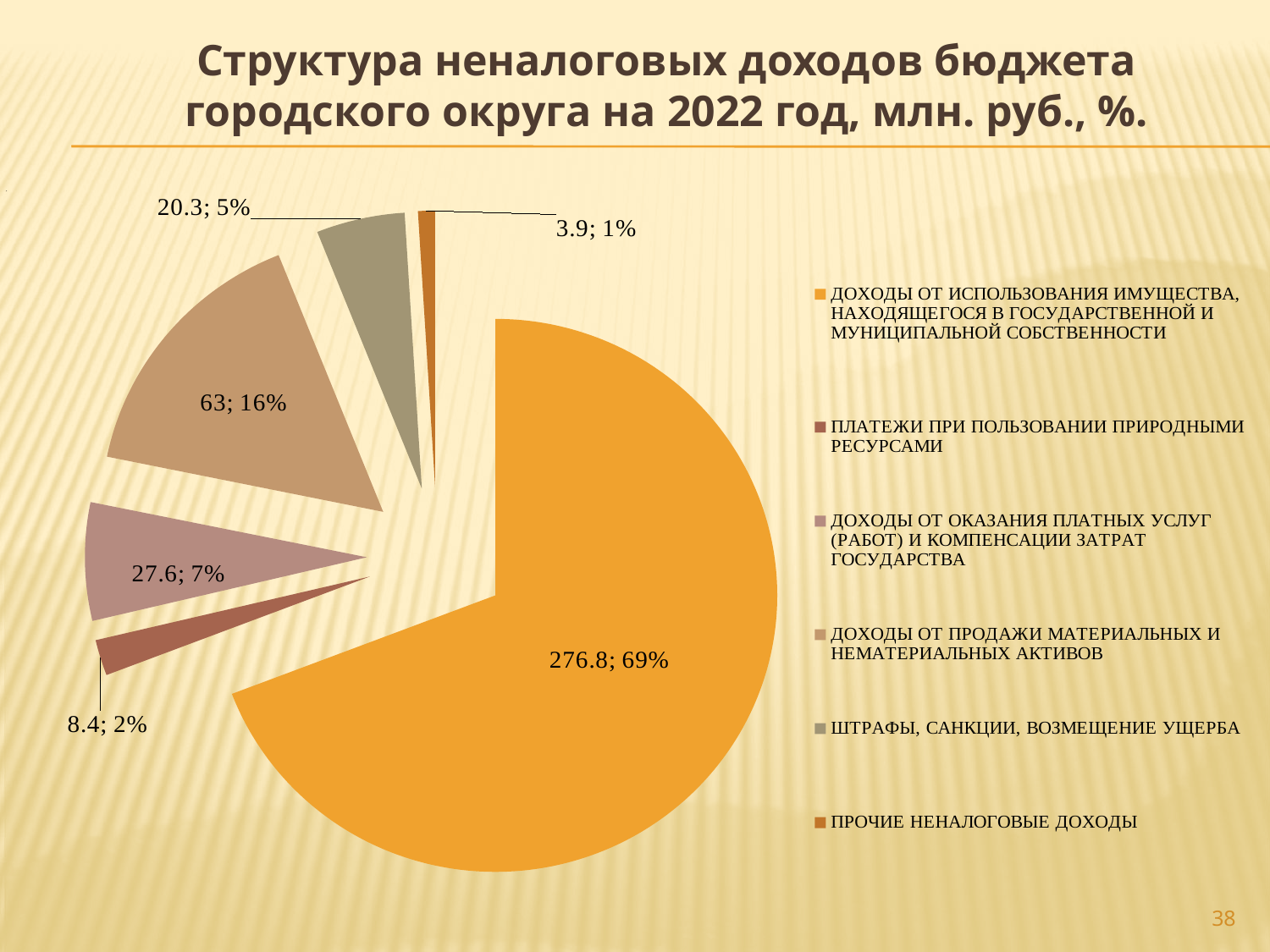
Что больше: доходы от продажи материальных и нематериальных активов или штрафы, санкции, возмещение ущерба? Доходы от продажи материальных и нематериальных активов Какая категория имеет наибольшую долю в структуре неналоговых доходов? Доходы от использования имущества, находящегося в государственной и муниципальной собственности Какую долю в процентах занимает категория «Доходы от продажи материальных и нематериальных активов»? 16% Какое значение (млн. руб.) указано для категории «Штрафы, санкции, возмещение ущерба»? 20.3 На сколько млн. руб. доходы от оказания платных услуг (работ) и компенсации затрат государства больше платежей при пользовании природными ресурсами? 19.2 Сколько категорий перечислено в легенде диаграммы? 6 Какую долю в процентах занимает категория «Платежи при пользовании природными ресурсами»? 2% Какой тип диаграммы показан на слайде? круговая диаграмма Какое значение (млн. руб.) указано для категории «Доходы от использования имущества, находящегося в государственной и муниципальной собственности»? 276.8 Какая категория имеет наименьшую долю в структуре неналоговых доходов? Прочие неналоговые доходы Какое значение (млн. руб.) указано для категории «Прочие неналоговые доходы»? 3.9 Какой год указан в заголовке диаграммы? 2022